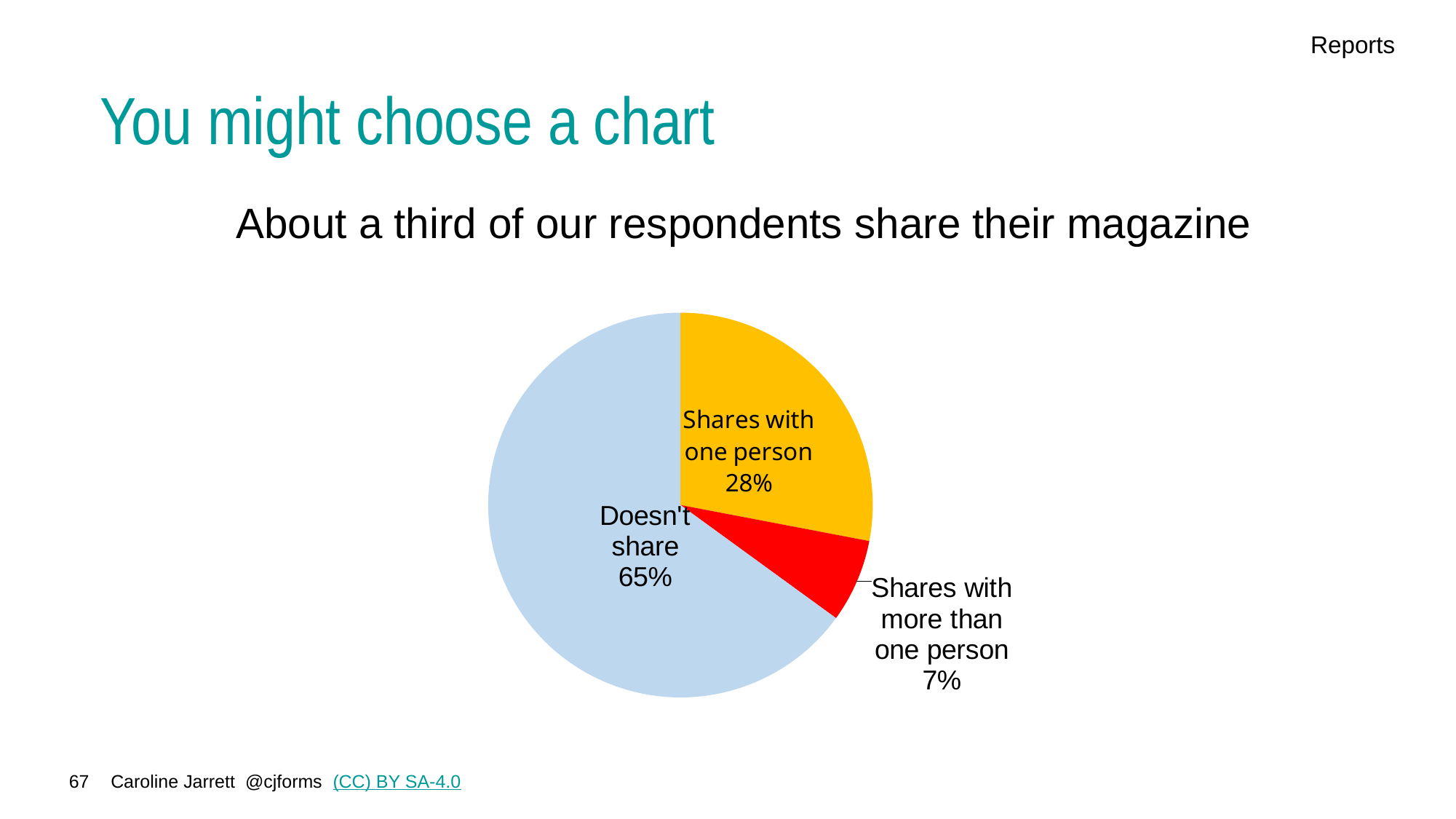
Which category has the smallest share of the pie? Shares with more than one person What is the difference in percentage points between 'Doesn't share' and 'Shares with one person'? 37 What is the difference in percentage points between 'Shares with one person' and 'Shares with more than one person'? 21 Which is larger: the share for 'Shares with one person' or 'Shares with more than one person'? Shares with one person What percentage of respondents doesn't share their magazine? 65% Which category has the largest share of the pie? Doesn't share What kind of chart is shown on the slide? pie chart What percentage of respondents shares with one person? 28% How many slices does the pie chart have? 3 What percentage of respondents shares with more than one person? 7% What is the combined percentage of respondents who share their magazine (with one person or more than one person)? 35% What colour is the 'Doesn't share' slice? light blue